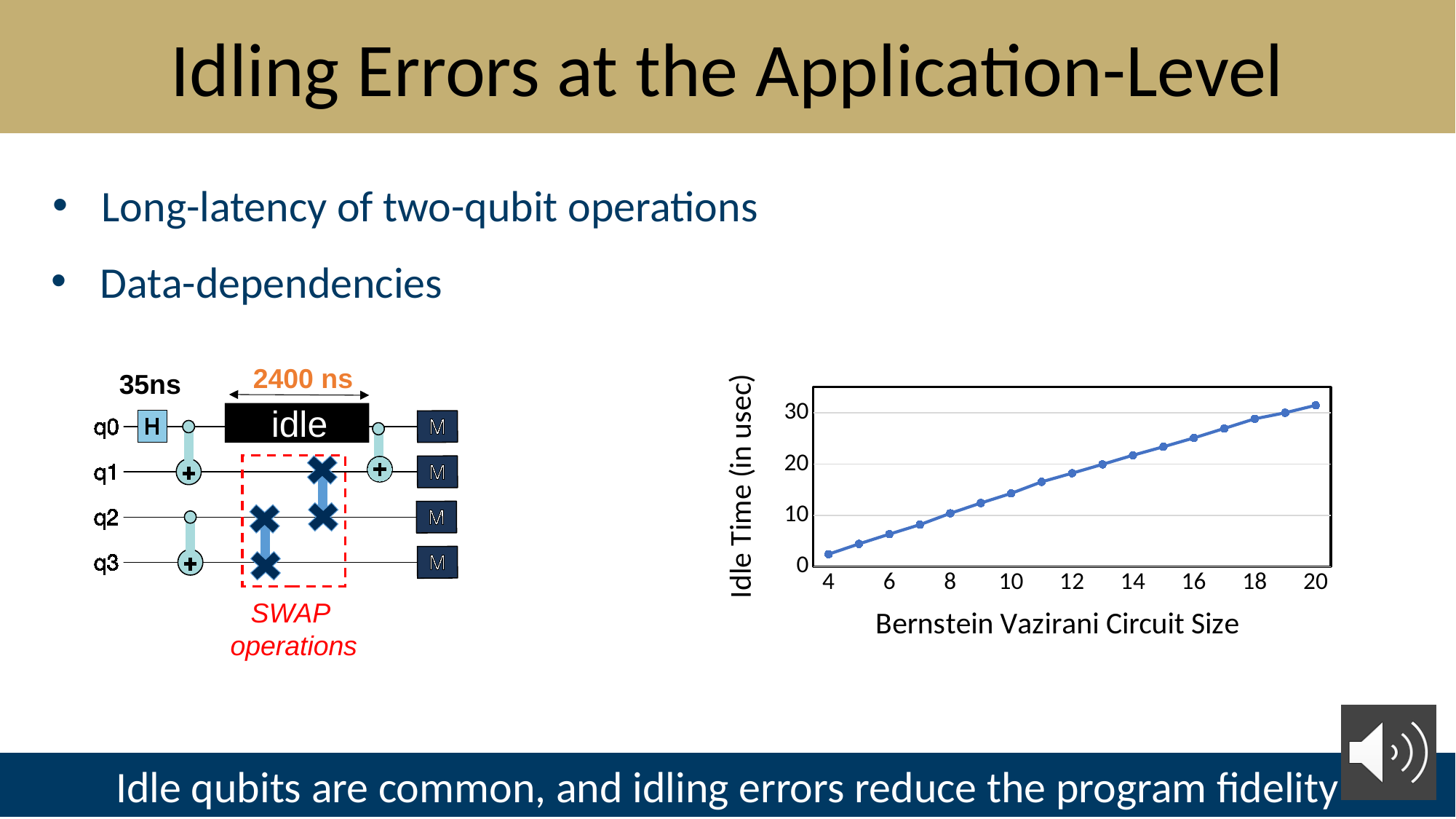
Which has the larger idle time, circuit size 6 or circuit size 18? 18 At which circuit size is the idle time lowest? 4 How many data points are plotted on the line? 17 Is the idle time for circuit size 4 greater or less than 10? less What kind of chart is shown on the right of the slide? line chart Does the idle time rise or fall as the Bernstein Vazirani circuit size increases? rise Is the idle time for circuit size 10 greater or less than 10? greater At which circuit size is the idle time highest? 20 What is the label of the y axis of the chart? Idle Time (in usec) Is the idle time for circuit size 16 greater or less than 20? greater What is the label of the x axis of the chart? Bernstein Vazirani Circuit Size